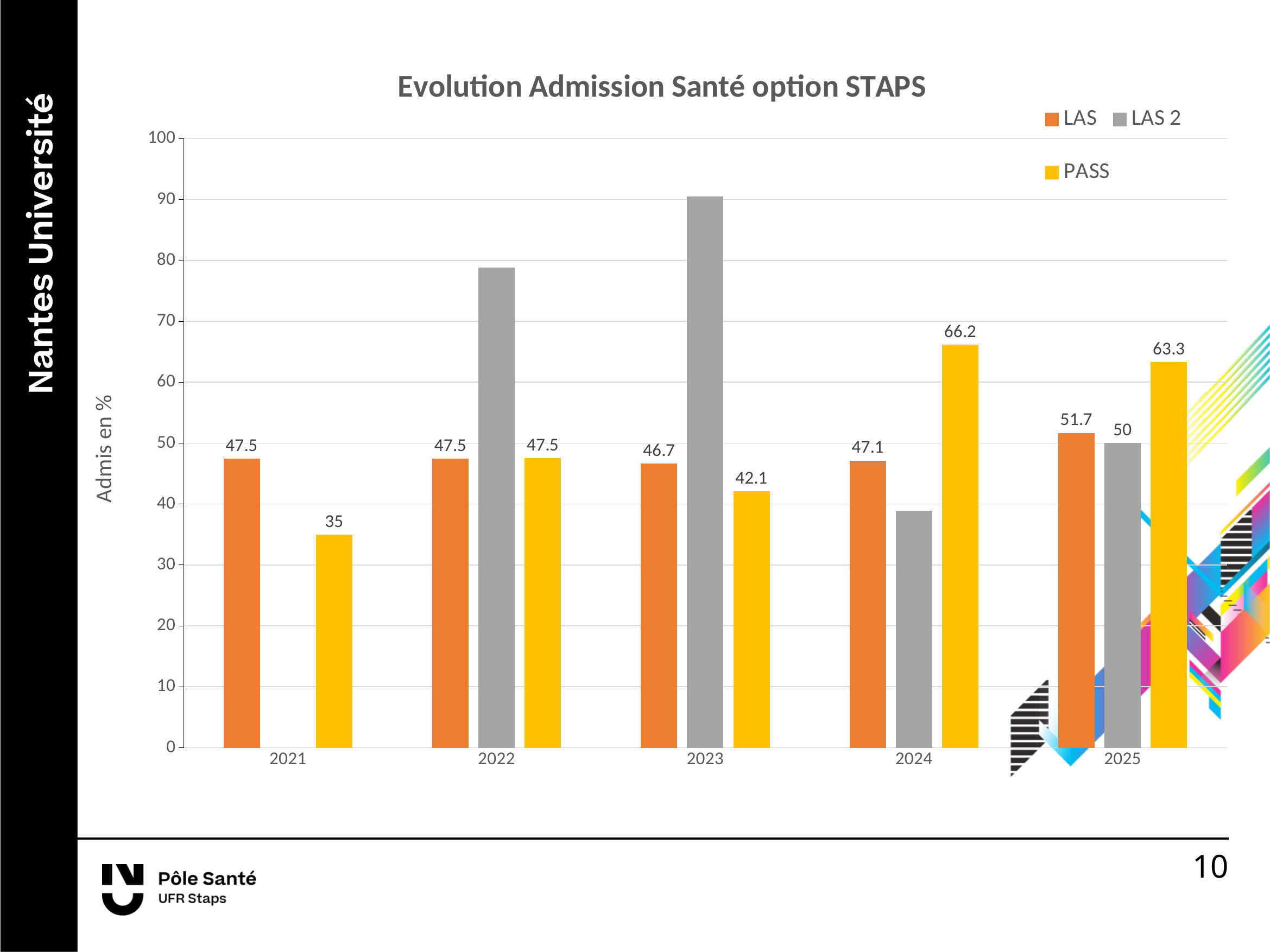
What is the value for PASS in 2023? 42.1 In which year is the PASS value highest? 2024 What is the difference between the PASS value in 2024 and the PASS value in 2021? 31.2 What is the value for PASS in 2021? 35 What is the value for LAS in 2025? 51.7 In which year is the PASS value lowest? 2021 How many years are shown on the x axis? 5 How many series does the legend list? 3 What is the value for LAS 2 in 2025? 50 What kind of chart is shown on the slide? bar chart Which is larger in 2025, the LAS value or the PASS value? PASS Is the value for LAS 2 in 2023 greater or less than 80? greater